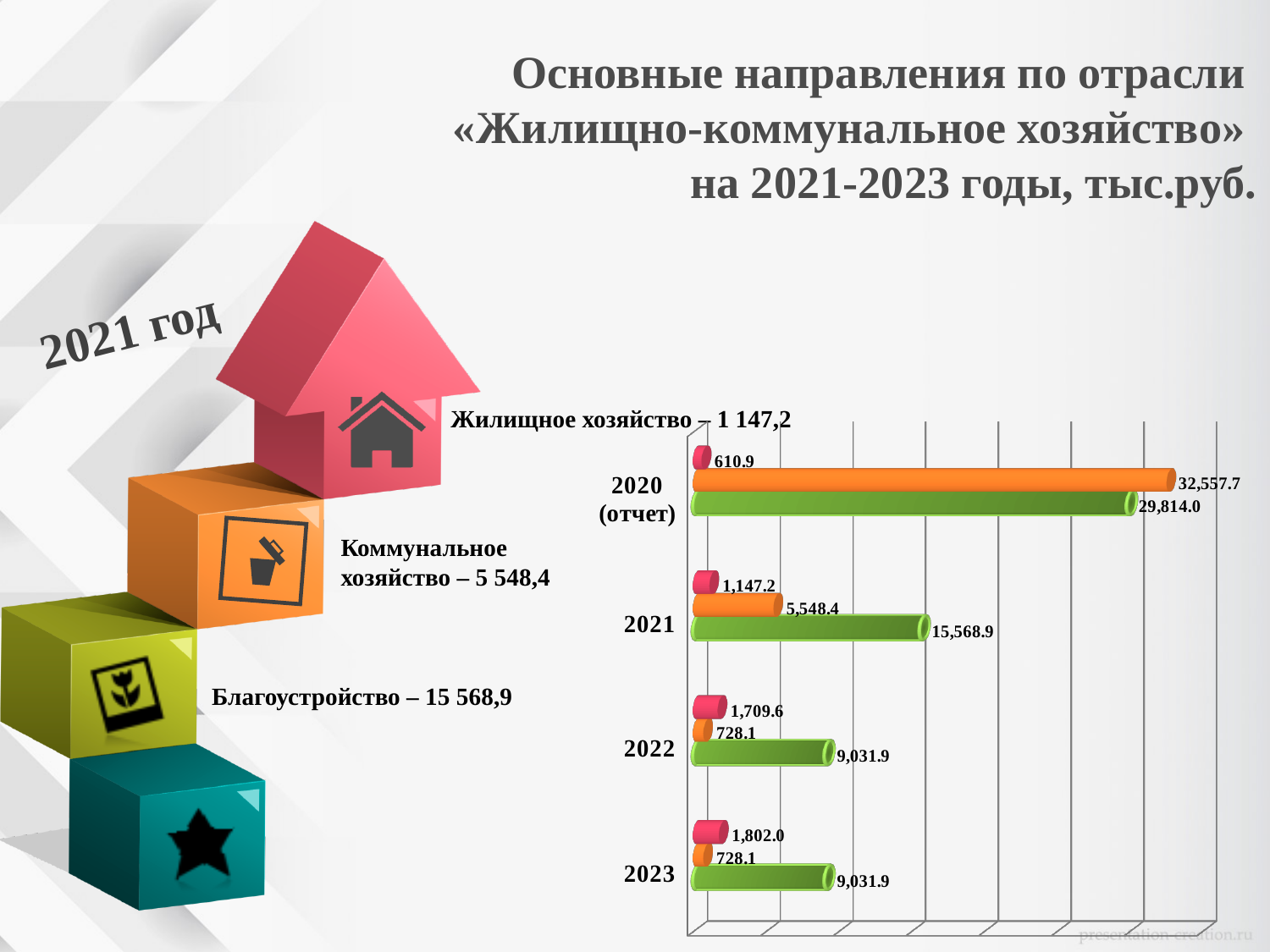
How many year categories does the chart show? 4 Do the green bar values rise or fall from 2020 (отчет) to 2023? fall How many bars are plotted for each year in the chart? 3 What kind of chart is shown on the slide? bar chart What is the value of the orange bar for 2022? 728.1 In which year is the green bar the highest? 2020 (отчет) What is the value of the pink bar for 2023? 1,802.0 Which is larger for 2021, the orange bar or the green bar? the green bar What is the difference between the orange and green bars for 2020 (отчет)? 2,743.7 What is the value of the orange bar for 2020 (отчет)? 32,557.7 In which year is the pink bar the lowest? 2020 (отчет) What is the value of the green bar for 2021? 15,568.9